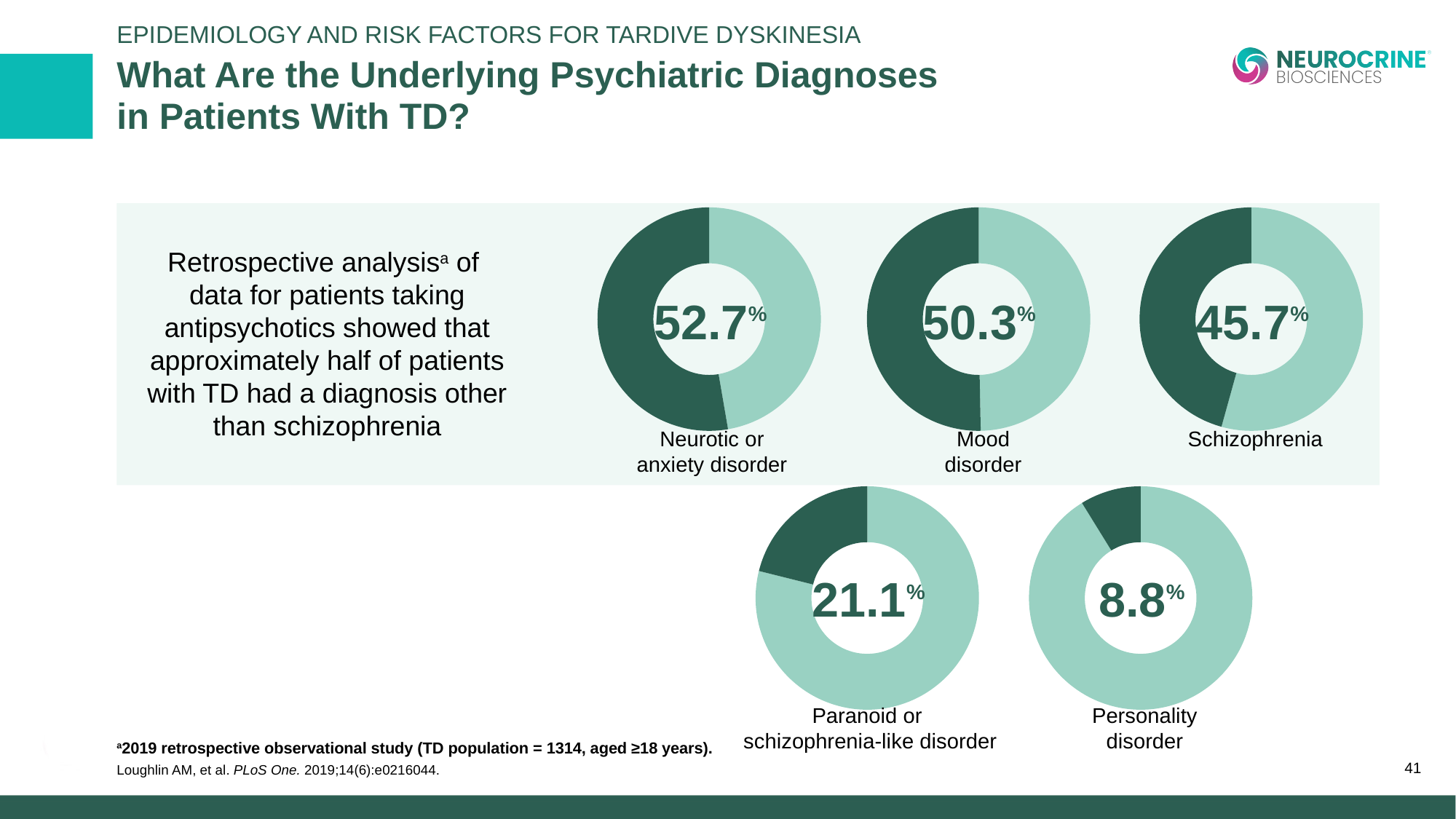
Which diagnosis has the lowest percentage across the donut charts on the slide? Personality disorder Which is larger, the percentage for Schizophrenia or the percentage for Paranoid or schizophrenia-like disorder? Schizophrenia Which diagnosis has the highest percentage across the donut charts on the slide? Neurotic or anxiety disorder What is the difference between the percentage for Schizophrenia and the percentage for Personality disorder? 36.9% What percentage is shown in the donut chart labelled "Mood disorder"? 50.3% What percentage is shown in the donut chart labelled "Personality disorder"? 8.8% What percentage is shown in the donut chart labelled "Neurotic or anxiety disorder"? 52.7% What is the difference between the percentage for Neurotic or anxiety disorder and the percentage for Mood disorder? 2.4% What kind of chart is used to display each diagnosis percentage on the slide? Donut chart How many donut charts are shown on the slide? 5 What percentage is shown in the donut chart labelled "Paranoid or schizophrenia-like disorder"? 21.1% What percentage is shown in the donut chart labelled "Schizophrenia"? 45.7%